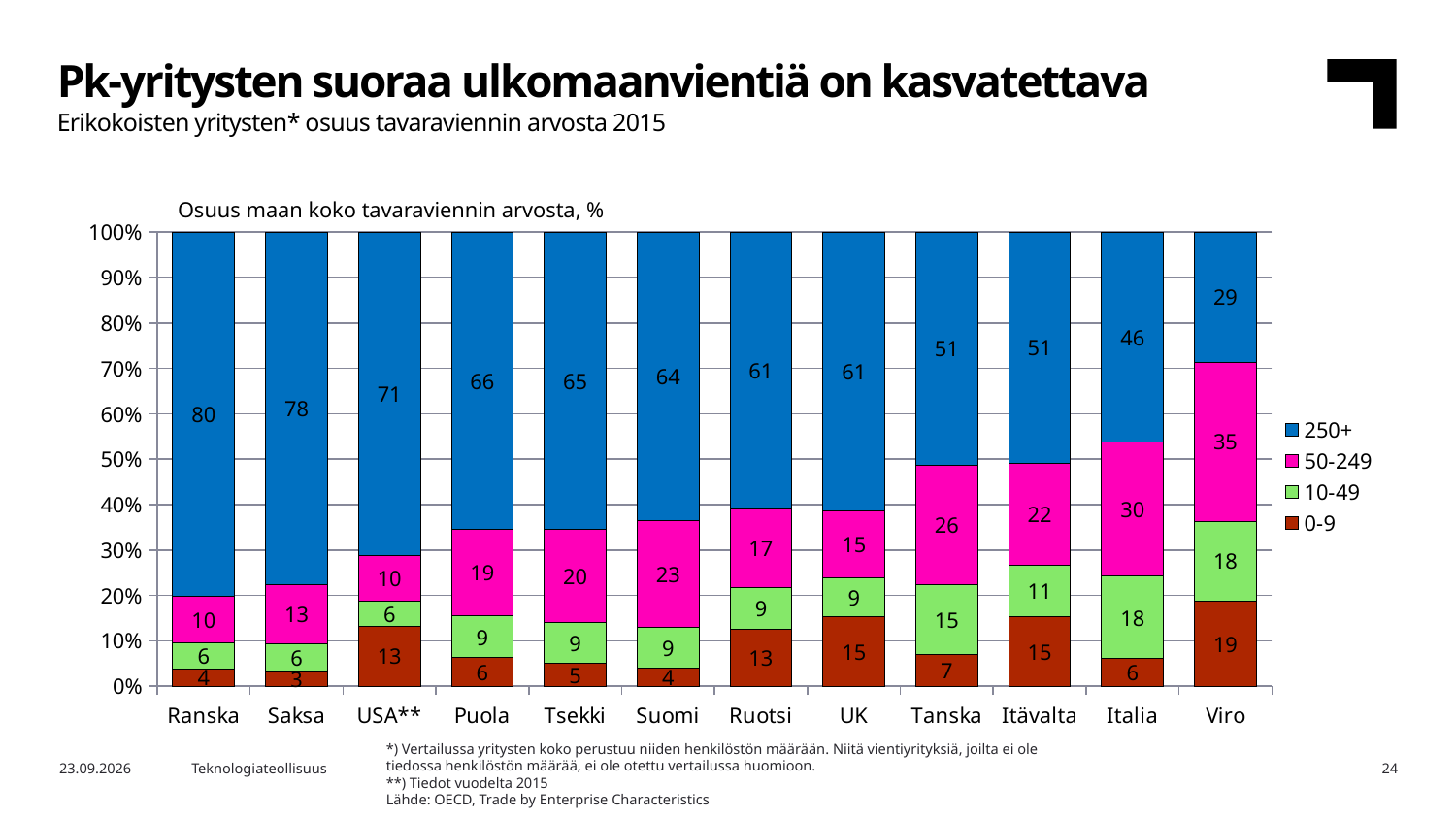
What is the title printed above the chart? Osuus maan koko tavaraviennin arvosta, % What is the value for the 50-249 series for Viro? 35 What is the value for the 250+ series for Ranska? 80 What kind of chart is shown on the slide? Stacked bar chart How many series does the legend list? 4 Which is larger, the 50-249 value for Suomi or the 50-249 value for Ruotsi? Suomi Which country has the lowest value for the 250+ series? Viro What is the value for the 0-9 series for UK? 15 How many countries are shown on the x axis? 12 What is the difference between the 250+ values for Ranska and Viro? 51 What is the value for the 10-49 series for Italia? 18 Which country has the highest value for the 250+ series? Ranska